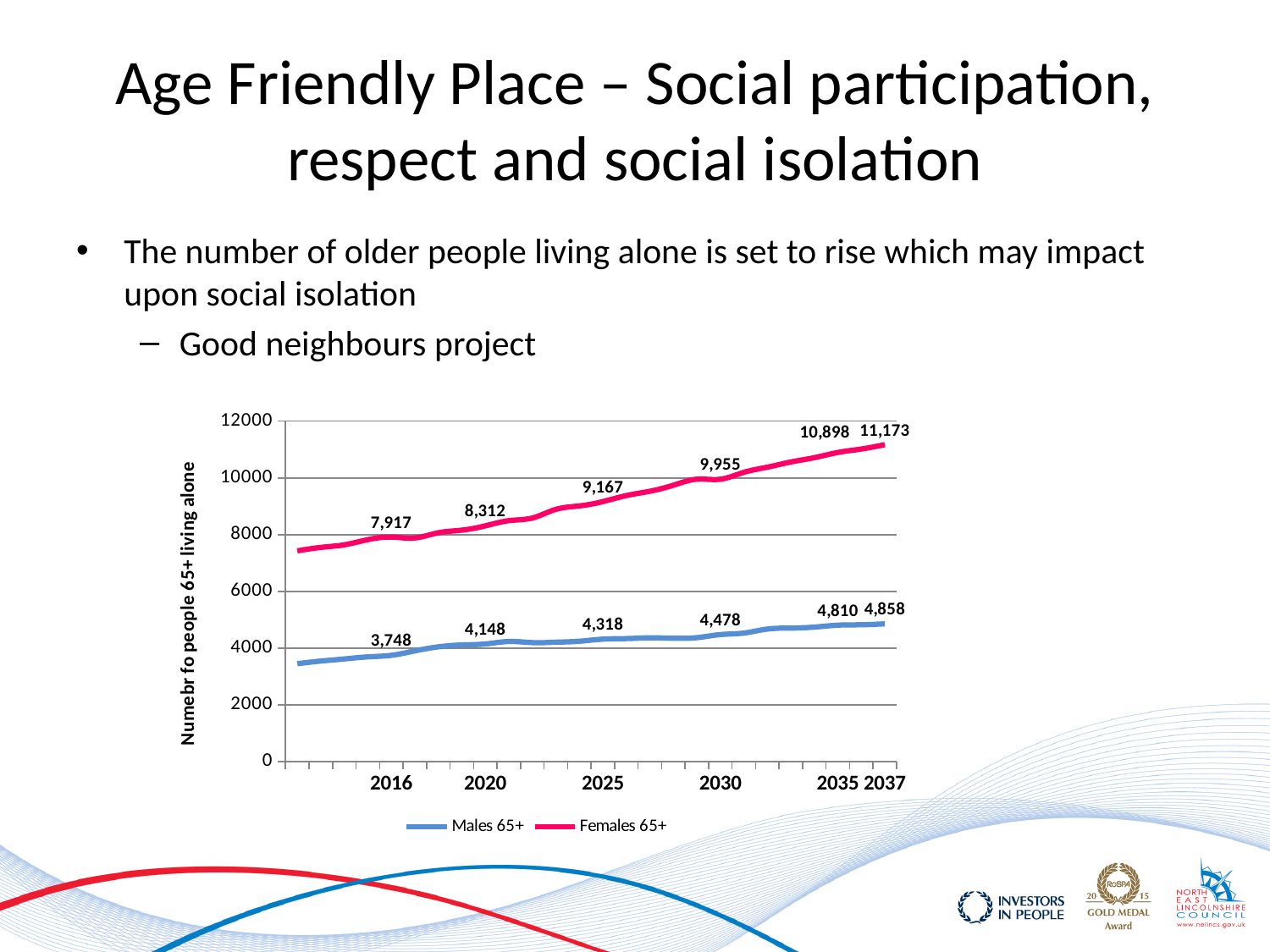
Which series has the higher value in 2020, Males 65+ or Females 65+? Females 65+ What is the value for Males 65+ in 2037? 4,858 How many series does the legend list? 2 What is the value for Females 65+ in 2030? 9,955 What is the value for Males 65+ in 2025? 4,318 What kind of chart is shown on the slide? Line chart Is the value for Males 65+ in 2030 greater or less than 6000? less Do the values for Females 65+ rise or fall from 2016 to 2037? Rise What is the value for Females 65+ in 2016? 7,917 By how much does the Females 65+ value increase from 2016 to 2037? 3,256 What is the difference between the Females 65+ and Males 65+ values in 2037? 6,315 What colour is the line for Females 65+? Pink/red